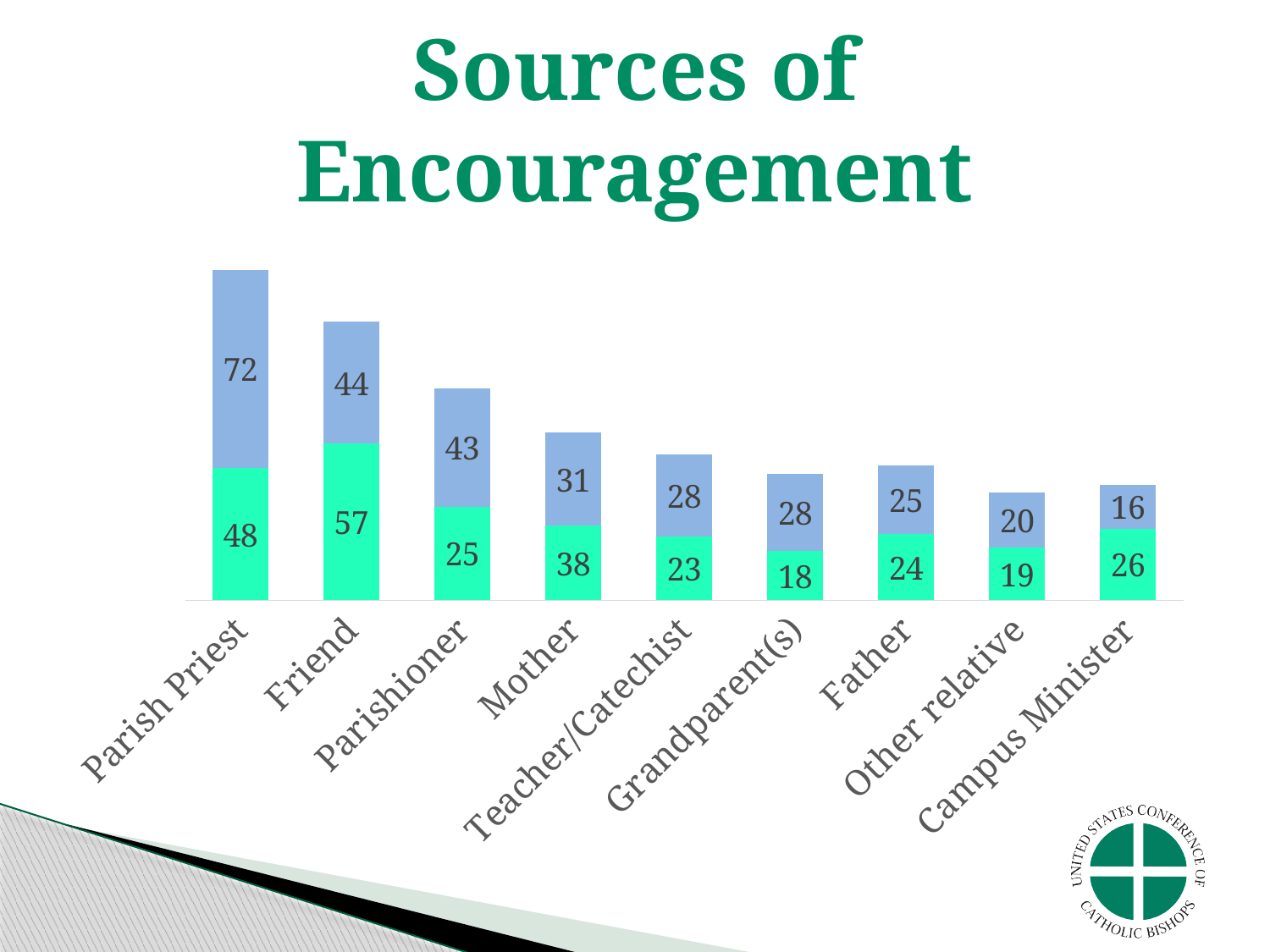
What is the value of the green (bottom) segment for Campus Minister? 26 Which is larger, the green (bottom) segment for Friend or the green (bottom) segment for Mother? Friend Which category has the shortest stacked bar? Other relative What is the value of the blue (top) segment for Friend? 44 What is the value of the green (bottom) segment for Parish Priest? 48 How many categories are shown on the x axis? 9 What is the title of the chart? Sources of Encouragement What kind of chart is shown on the slide? Stacked bar chart What is the total of the stacked bar for Parish Priest? 120 Which category has the tallest stacked bar? Parish Priest What is the total of the stacked bar for Mother? 69 What is the difference between the blue (top) segment values for Parish Priest and Friend? 28